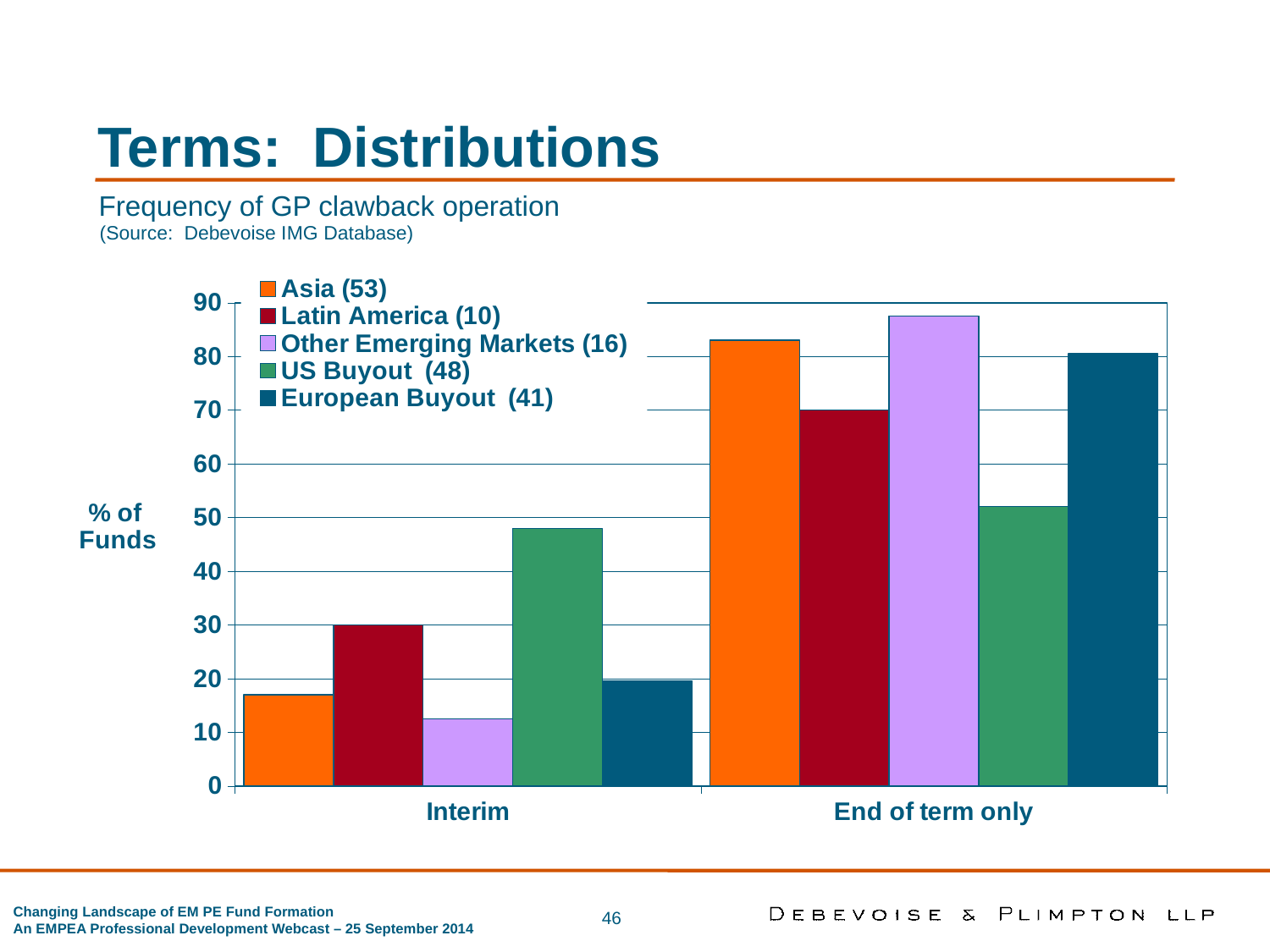
Is the value for US Buyout in the Interim category greater or less than 40? greater In the Interim category, which is larger: Latin America or European Buyout? Latin America Is the value for Other Emerging Markets in the Interim category greater or less than 20? less Which series has the lowest value in the Interim category? Other Emerging Markets Which series has the highest value in the End of term only category? Other Emerging Markets How many categories are shown on the x axis? 2 How many series does the legend list? 5 Is the value for European Buyout in the End of term only category greater or less than 70? greater What is the label on the y axis? % of Funds Which series has the highest value in the Interim category? US Buyout What kind of chart is shown on the slide? bar chart Which series has the lowest value in the End of term only category? US Buyout